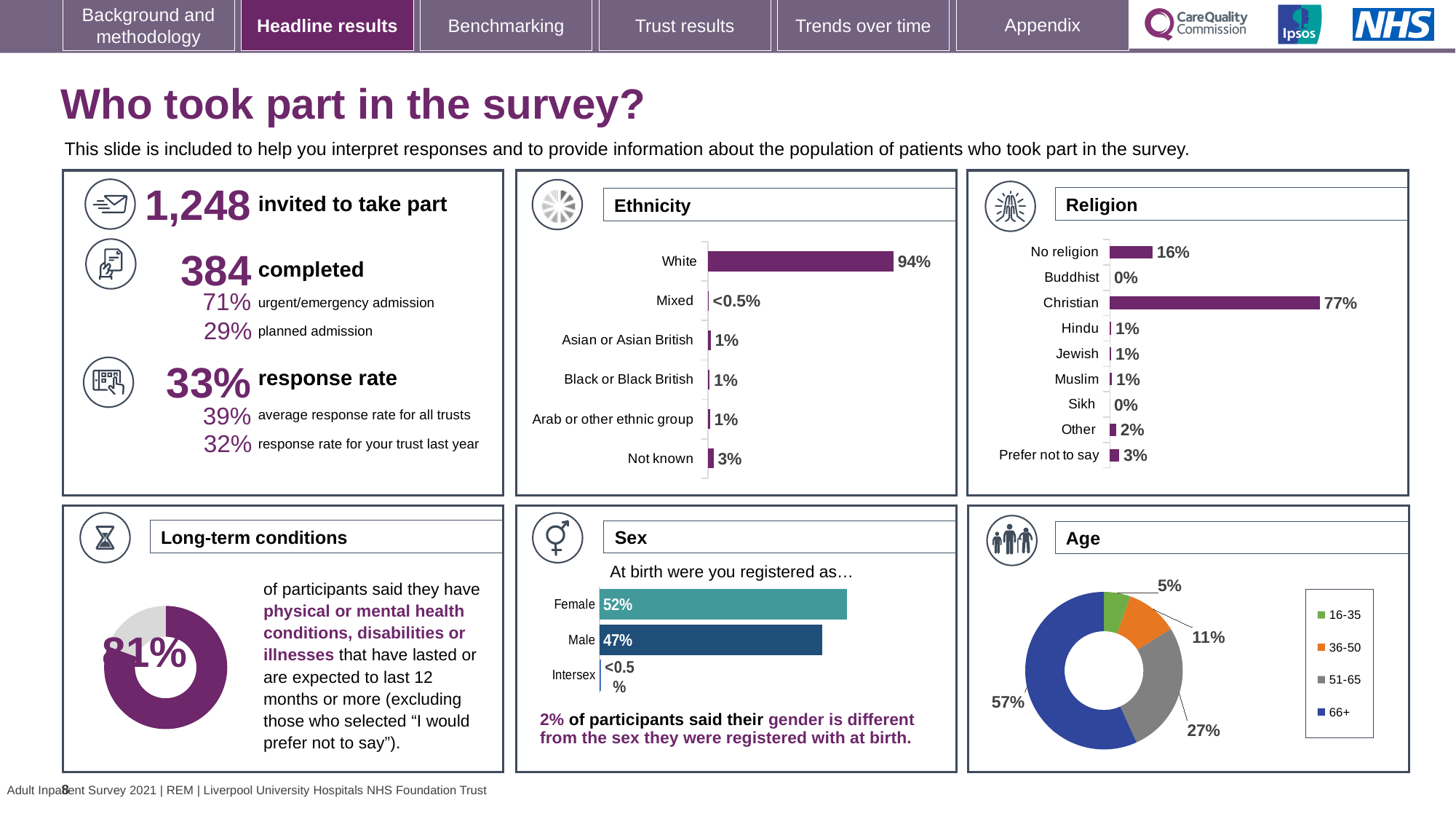
In the Sex chart, which is larger, the Female or the Male value? Female In the Ethnicity chart, what percentage of respondents were White? 94% In the Age chart, how many age groups does the legend list? 4 In the Sex chart, what percentage of participants were registered as Female at birth? 52% In the Age chart, what share of participants were aged 66+? 57% In the Religion chart, what is the value for No religion? 16% In the Religion chart, which religion category has the highest value? Christian In the Religion chart, what is the difference between the Christian and No religion values? 61 percentage points In the Religion chart, how many categories are plotted? 9 What kind of chart is used in the Age panel? Donut (pie) chart In the Ethnicity chart, what is the value for Not known? 3% In the Ethnicity chart, how many ethnic categories are plotted? 6